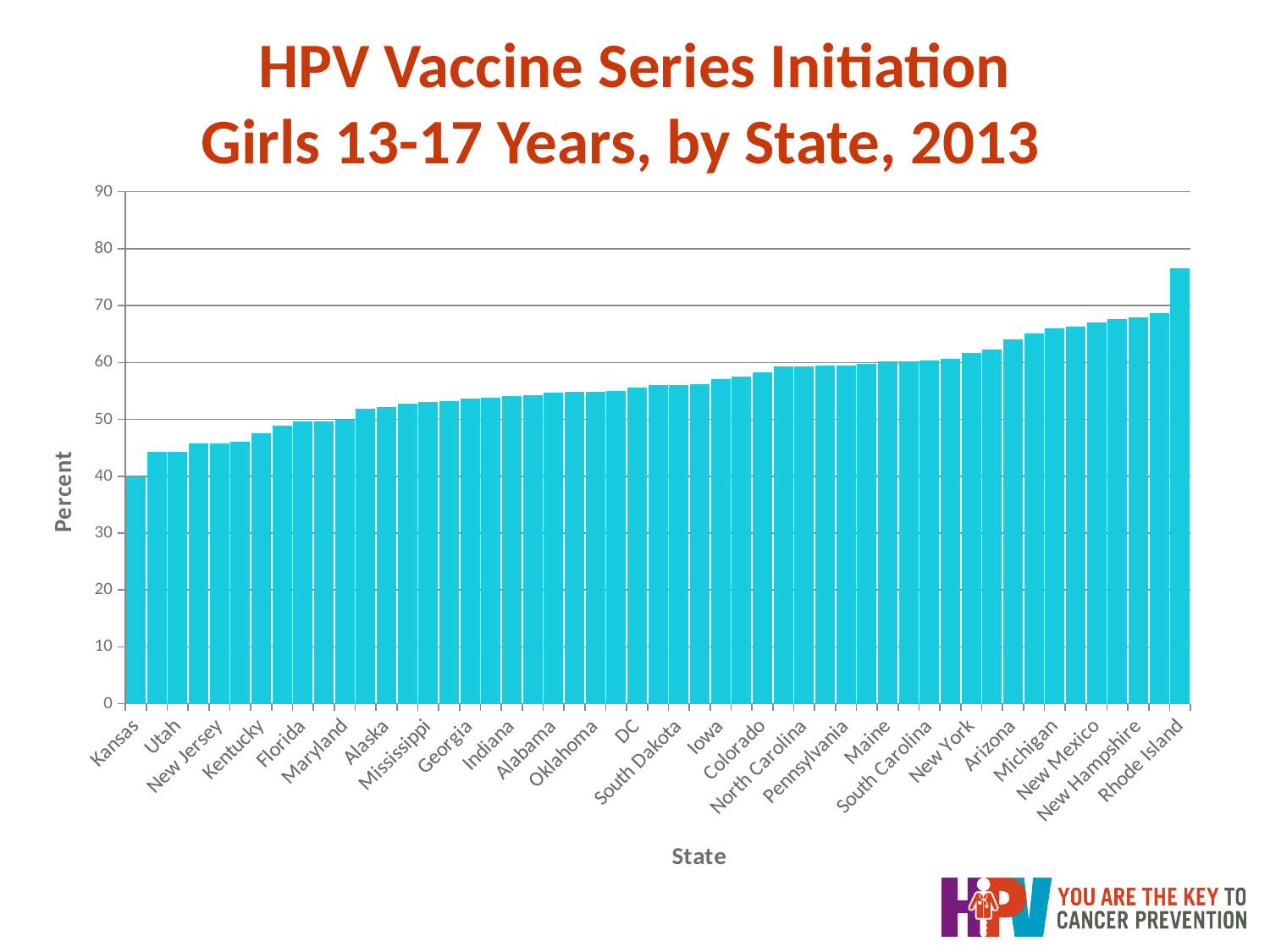
Is the value for Florida greater or less than 60? less What is the label on the horizontal axis? State Which state has the lowest HPV vaccine series initiation percentage? Kansas Do the values rise or fall moving from left to right along the x axis? rise What is the label on the vertical axis? Percent Which is larger, the value for Florida or the value for Michigan? Michigan Is the value for Utah greater or less than 50? less Is the value for Rhode Island greater or less than 70? greater Which state has the highest HPV vaccine series initiation percentage? Rhode Island Which is larger, the value for New York or the value for Utah? New York What kind of chart is shown on the slide? bar chart